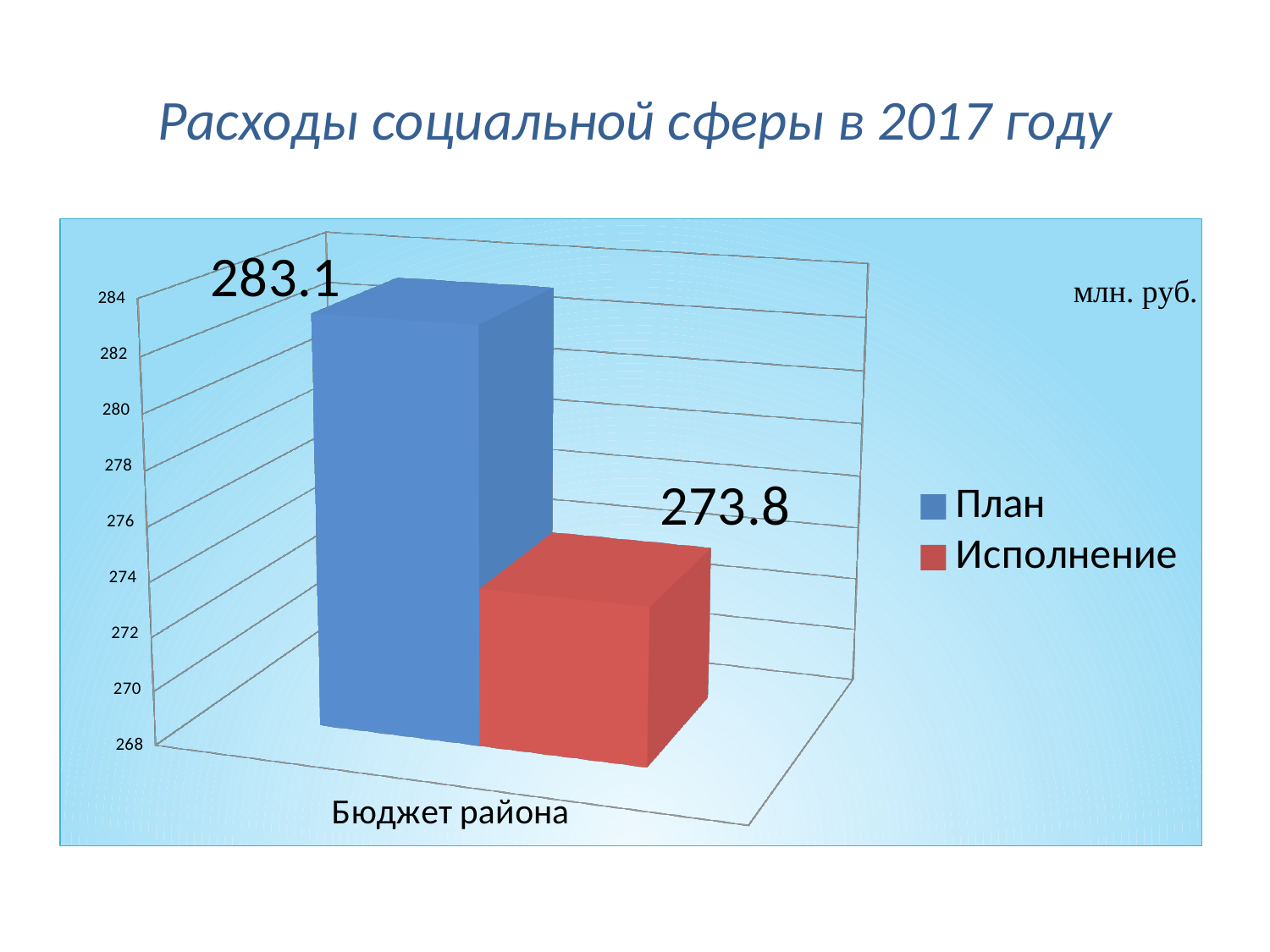
What unit is indicated on the chart? млн. руб. What is the value for Исполнение (Execution) for Бюджет района? 273.8 What kind of chart is shown on the slide? bar chart What is the difference between the План value and the Исполнение value? 9.3 What is the title of the slide? Расходы социальной сферы в 2017 году What is the value for План (Plan) for Бюджет района? 283.1 Is the value for Исполнение greater or less than 276? less How many categories are shown on the x axis? 1 Which series has the higher value, План or Исполнение? План How many series does the legend list? 2 Is the value for План greater or less than 280? greater Which series has the lowest value on the chart? Исполнение